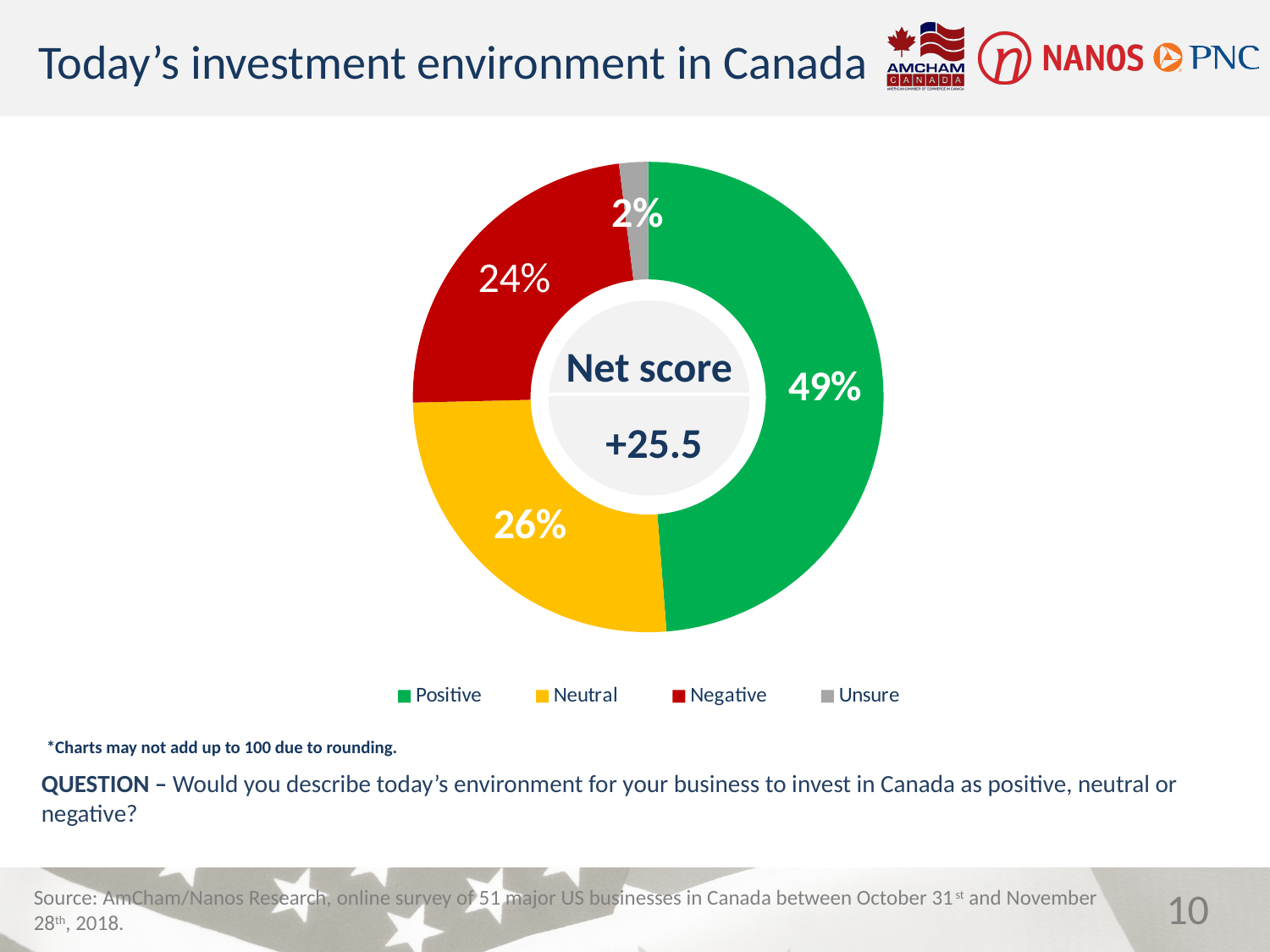
What percentage of respondents answered neutral? 26% What percentage of respondents were unsure? 2% What colour represents the Negative category in the chart? Red Which response category has the smallest share of the chart? Unsure What percentage of respondents described today's investment environment in Canada as positive? 49% What is the difference in percentage points between the positive and negative shares? 25 Which response category has the largest share of the chart? Positive What net score is shown in the centre of the chart? +25.5 How many categories does the chart show? 4 Which is larger, the neutral share or the negative share? Neutral What kind of chart is shown on the slide? Doughnut (pie) chart What percentage of respondents answered negative? 24%